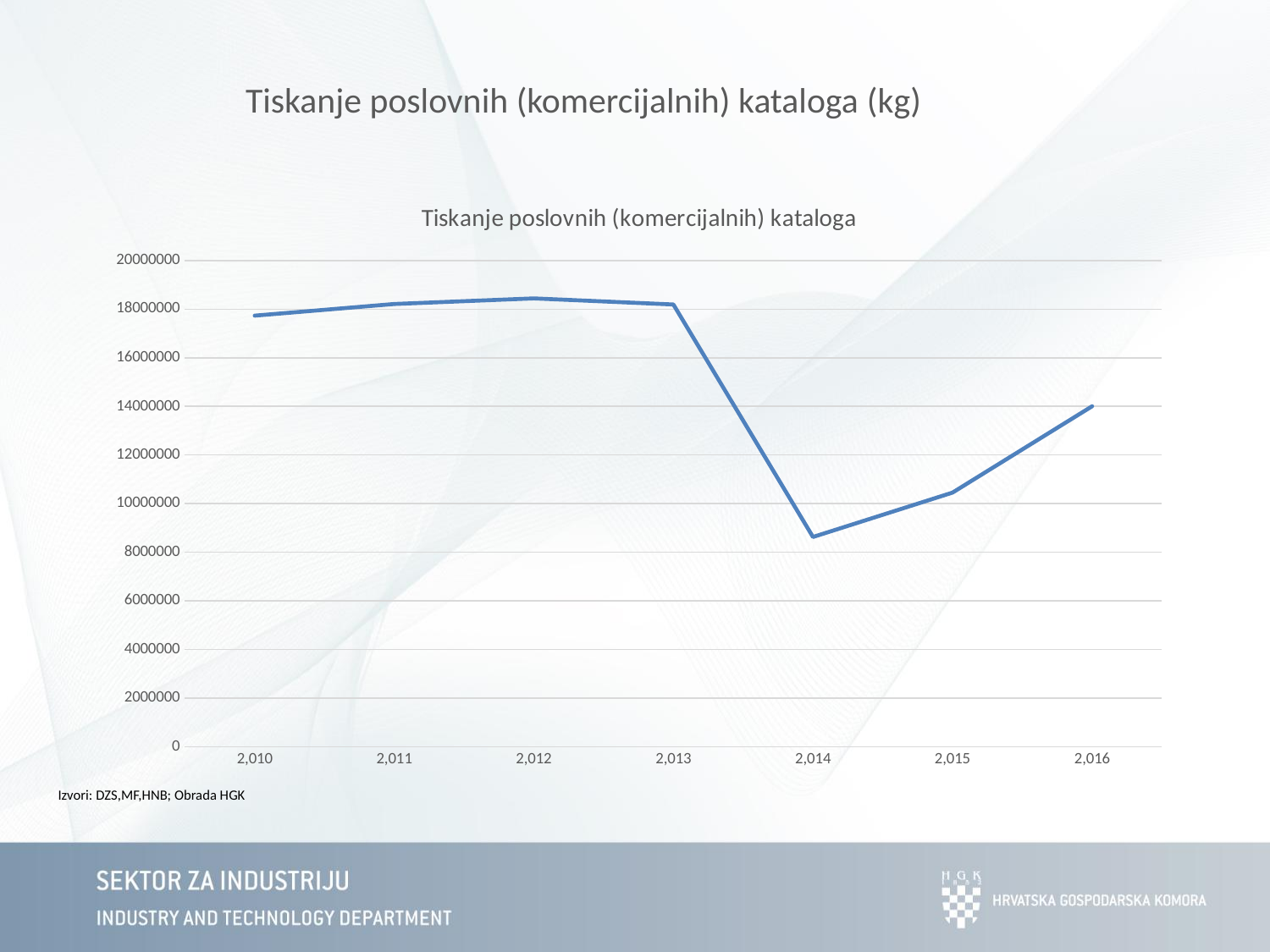
Which year has the larger value, 2,015 or 2,016? 2,016 Is the value for 2,016 greater or less than 12000000? greater Is the value for 2,015 greater or less than 12000000? less Is the value for 2,010 greater or less than 16000000? greater What kind of chart is shown on the slide? line chart Which year has the larger value, 2,013 or 2,014? 2,013 How many years are plotted on the x axis of the chart? 7 What is the title of the chart? Tiskanje poslovnih (komercijalnih) kataloga Does the value rise or fall from 2,013 to 2,014? fall Which year has the lowest value in the chart? 2,014